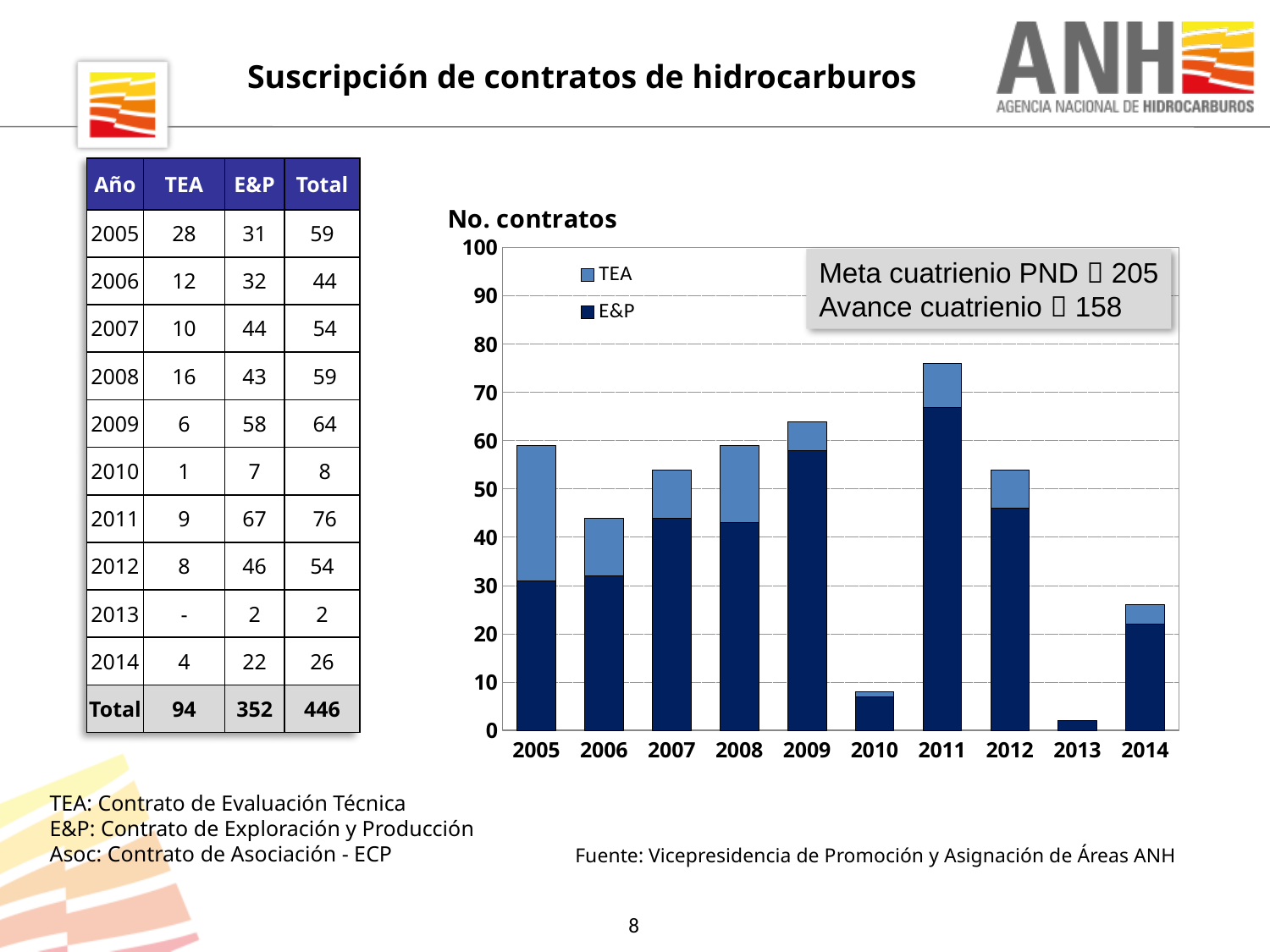
Which year has a taller stacked bar, 2005 or 2006? 2005 Which year has the shortest stacked bar in the chart? 2013 What kind of chart is shown on the slide? bar chart What is the E&P value for 2011? 67 What is the total of the stacked bar for 2014? 26 Which year has the tallest stacked bar in the chart? 2011 How many series does the chart legend list? 2 What is the difference between the total contracts in 2011 and in 2012? 22 What are the two series named in the chart legend? TEA and E&P Is the total value of the bar for 2010 greater or less than 10? less Is the total value of the bar for 2009 greater or less than 60? greater How many years are shown along the x axis of the chart? 10